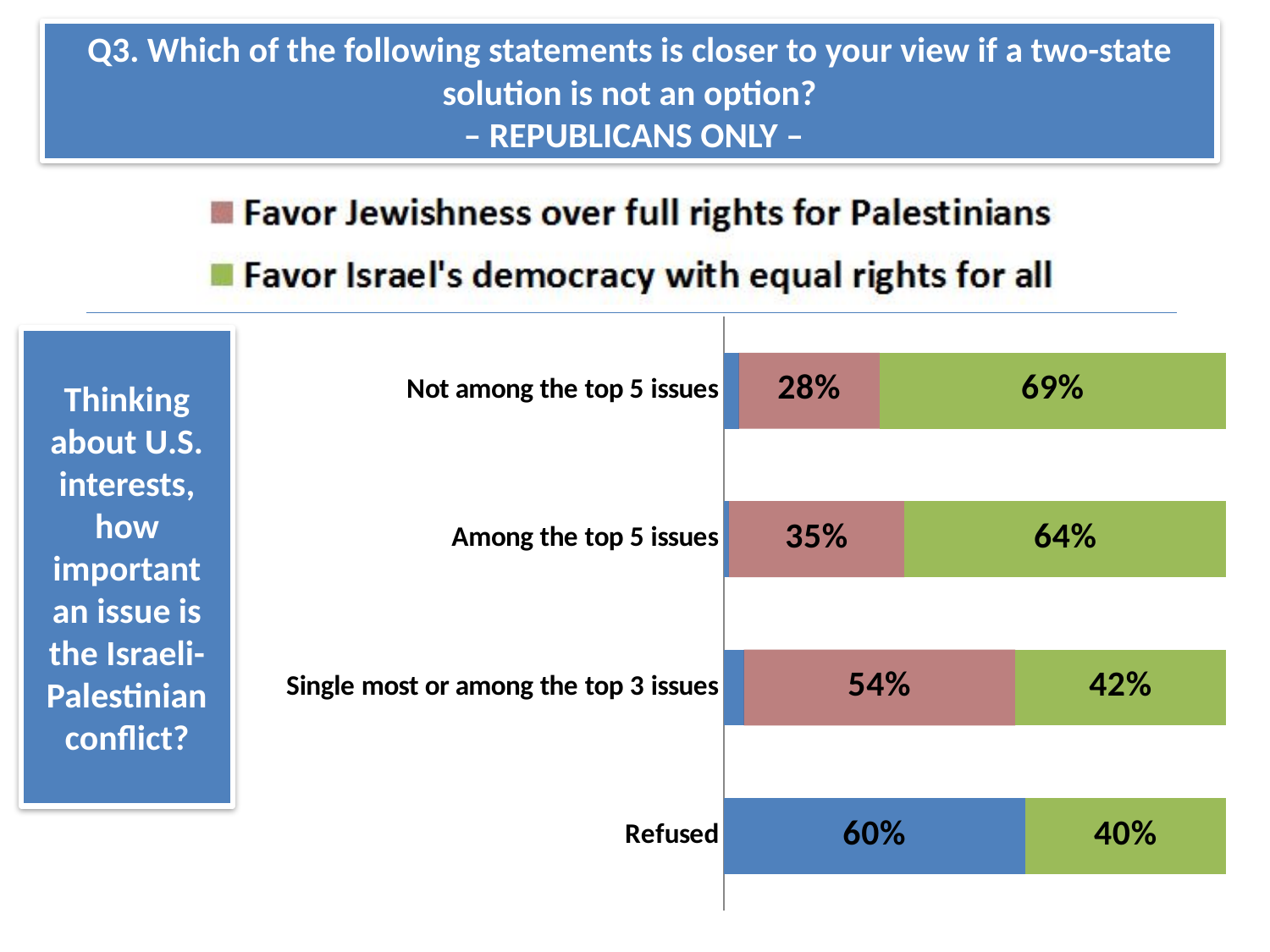
What kind of chart is shown on the slide? Stacked bar chart What is the value for 'Favor Jewishness over full rights for Palestinians' in the 'Single most or among the top 3 issues' category? 54% In the 'Single most or among the top 3 issues' category, what is the difference between the 'Favor Jewishness' value and the 'Favor Israel's democracy' value? 12 percentage points Which category has the lowest value for 'Favor Israel's democracy with equal rights for all'? Refused How many categories are shown on the chart? 4 What is the value for 'Favor Jewishness over full rights for Palestinians' in the 'Among the top 5 issues' category? 35% How many series does the legend list? 2 Which category has the highest value for 'Favor Jewishness over full rights for Palestinians'? Single most or among the top 3 issues What percentage of Republicans who say the conflict is not among the top 5 issues favor Israel's democracy with equal rights for all? 69% In the 'Among the top 5 issues' category, which is larger: 'Favor Jewishness over full rights for Palestinians' or 'Favor Israel's democracy with equal rights for all'? Favor Israel's democracy with equal rights for all What is the value for 'Favor Israel's democracy with equal rights for all' in the 'Refused' category? 40% In the 'Not among the top 5 issues' category, how many percentage points higher is 'Favor Israel's democracy with equal rights for all' than 'Favor Jewishness over full rights for Palestinians'? 41 percentage points